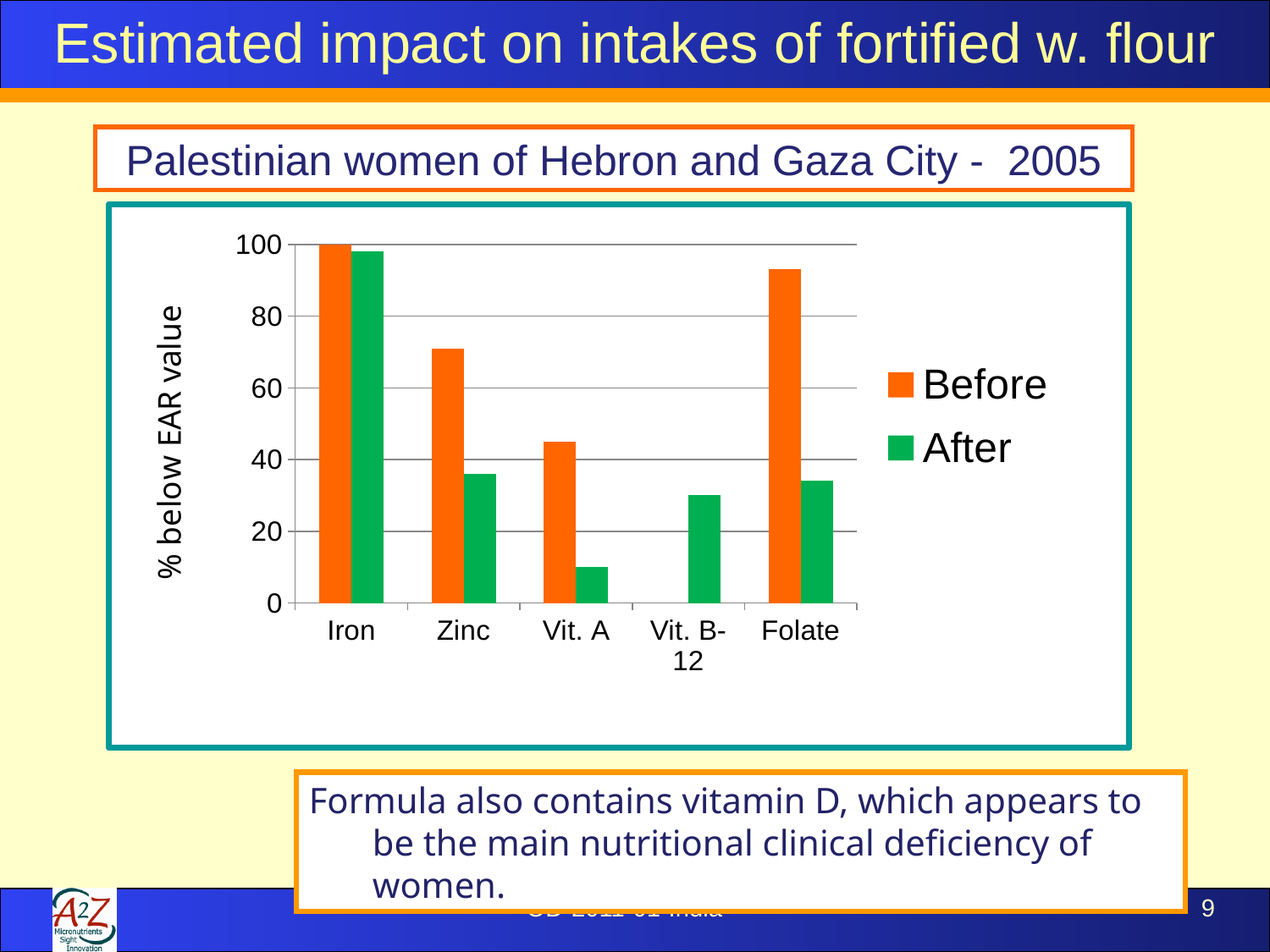
What is the label on the y axis of the chart? % below EAR value How many series does the chart legend list? 2 Which category has the lowest After value? Vit. A For Folate, which is larger, the Before value or the After value? Before What kind of chart is shown on the slide? bar chart How many nutrient categories are shown on the x axis of the chart? 5 Which category has the highest After value? Iron Is the After value for Folate greater or less than 40? less What is the Before value for Iron? 100 Is the After value for Vit. B-12 greater or less than 20? greater Which category has the highest Before value? Iron Is the Before value for Zinc greater or less than 60? greater